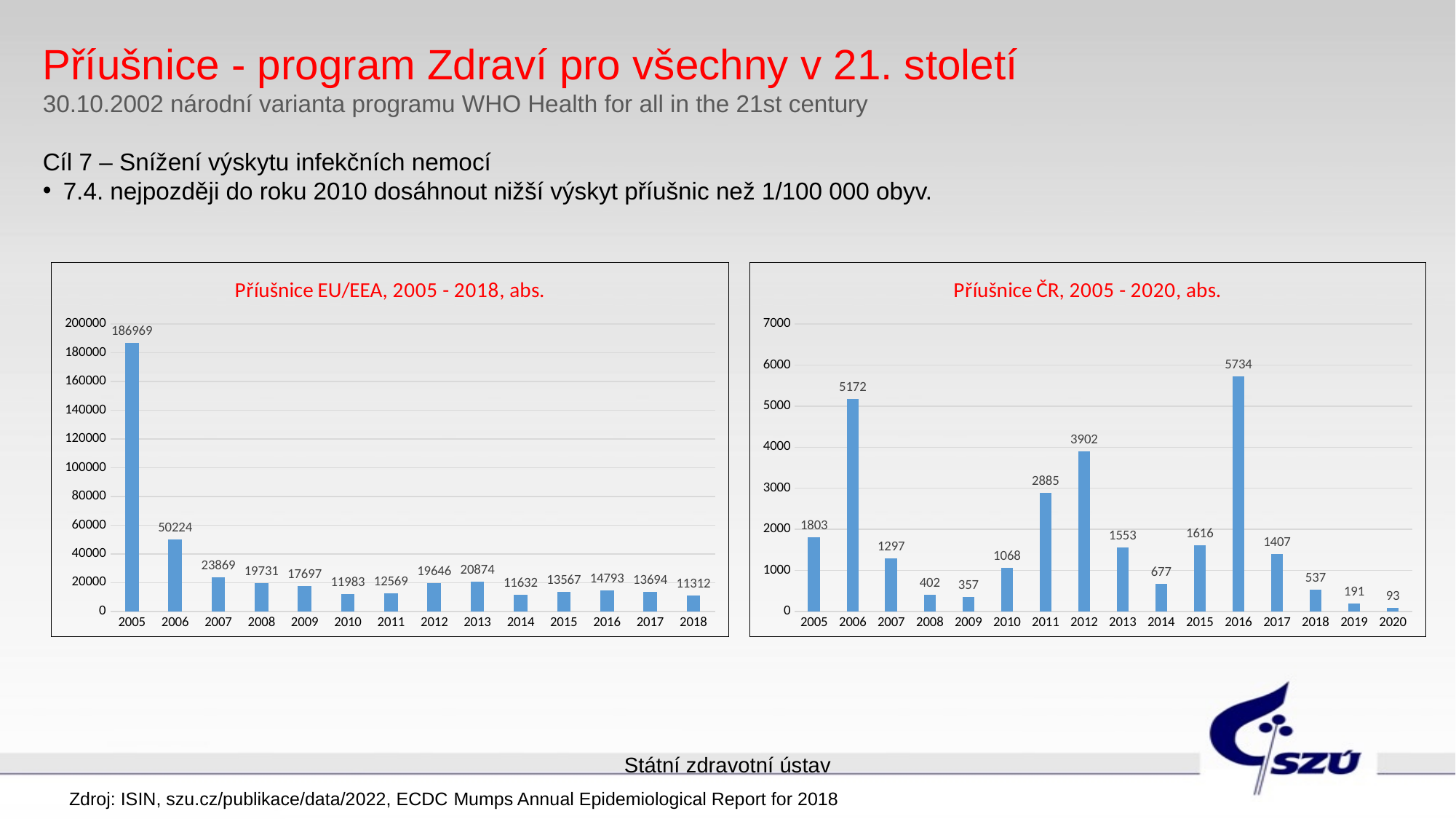
In the chart 'Příušnice ČR, 2005 - 2020, abs.', what is the value for 2016? 5734 How many years are shown in the chart 'Příušnice ČR, 2005 - 2020, abs.'? 16 In the chart 'Příušnice ČR, 2005 - 2020, abs.', is the value for 2011 greater or less than 2000? greater How many years are shown in the chart 'Příušnice EU/EEA, 2005 - 2018, abs.'? 14 In the chart 'Příušnice EU/EEA, 2005 - 2018, abs.', what is the value for 2018? 11312 In the chart 'Příušnice ČR, 2005 - 2020, abs.', which year has the lowest value? 2020 In the chart 'Příušnice EU/EEA, 2005 - 2018, abs.', which year has the highest value? 2005 What type of chart is 'Příušnice EU/EEA, 2005 - 2018, abs.'? Bar chart In the chart 'Příušnice EU/EEA, 2005 - 2018, abs.', what is the value for 2005? 186969 In the chart 'Příušnice EU/EEA, 2005 - 2018, abs.', which is larger, the value for 2012 or the value for 2013? 2013 What is the title of the chart on the right side of the slide? Příušnice ČR, 2005 - 2020, abs. In the chart 'Příušnice ČR, 2005 - 2020, abs.', what is the difference between the values for 2006 and 2007? 3875